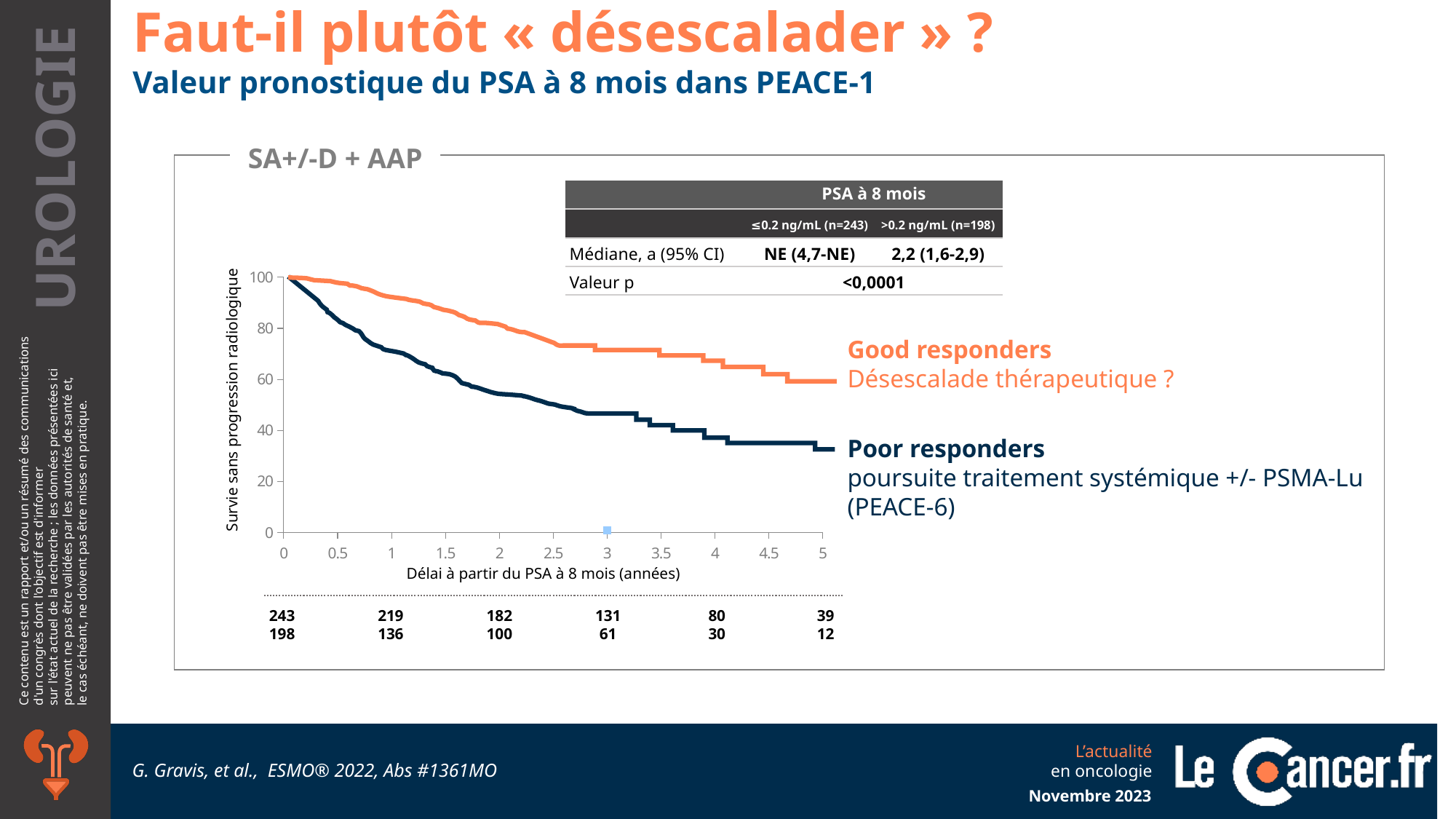
At 5 years, is the survival without radiological progression for Poor responders greater or less than 40? less Do the survival curves rise or fall as time from PSA at 8 months increases? Fall What p-value is reported for the comparison between the two PSA groups? <0,0001 Which group has the higher survival curve throughout the follow-up, Good responders or Poor responders? Good responders What is the difference between the number at risk in the ≤0.2 ng/mL group and the >0.2 ng/mL group at 5 years? 27 What kind of chart is shown on the slide? Line chart (Kaplan-Meier survival curve) What is the median survival without radiological progression (95% CI) for the >0.2 ng/mL group? 2,2 (1,6-2,9) What is the label of the x axis of the chart? Délai à partir du PSA à 8 mois (années) How many curves (groups) are plotted on the chart? 2 How many patients were at risk in the ≤0.2 ng/mL group at time 0? 243 At 5 years, is the survival without radiological progression for Good responders greater or less than 40? greater How many patients were at risk in the >0.2 ng/mL group at 3 years? 61